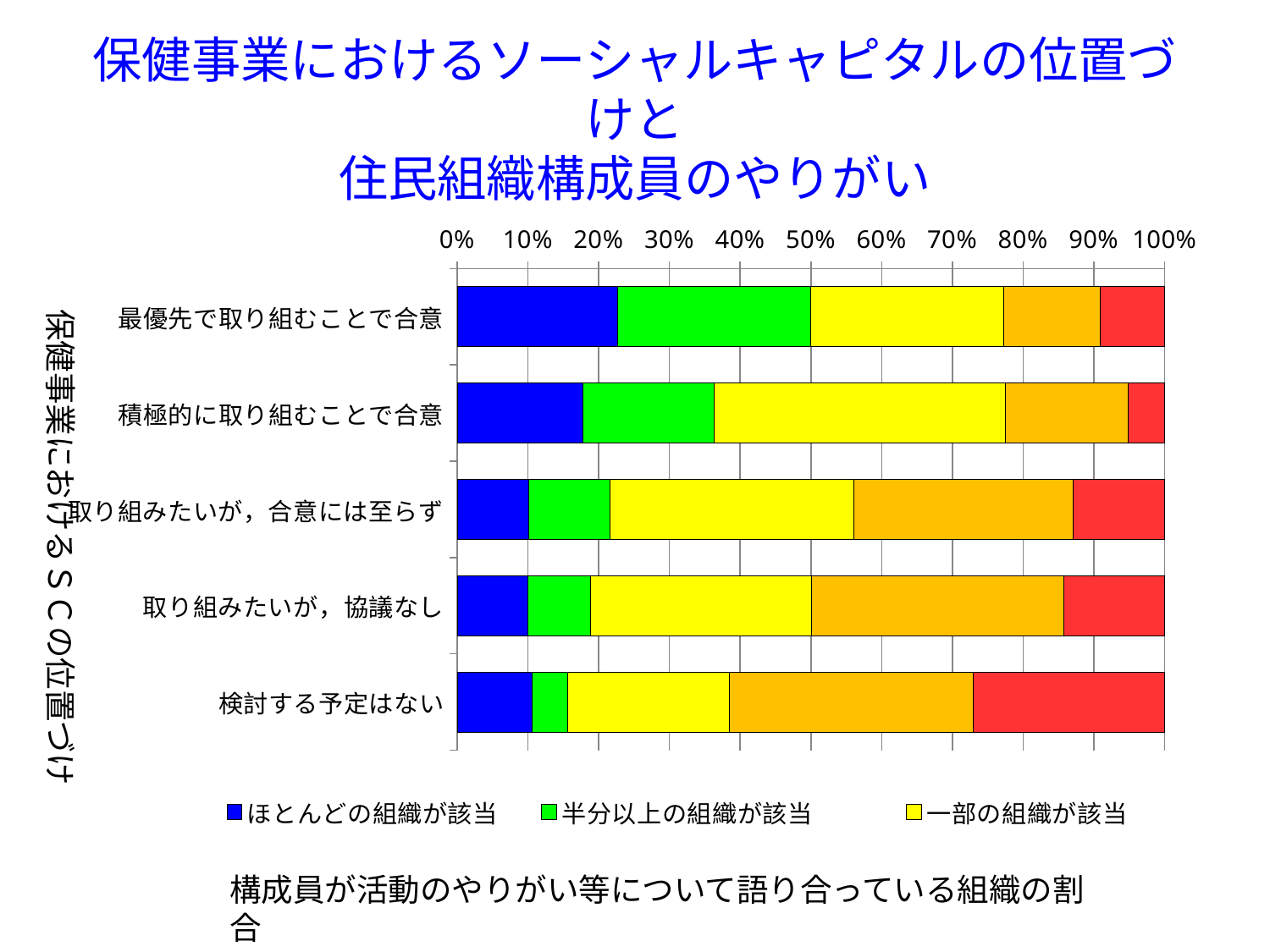
How many series does the legend list? 3 Is the blue segment for 検討する予定はない greater or less than 20%? less Which category has the largest red segment? 検討する予定はない What kind of chart is shown on the slide? Stacked bar chart Is the blue segment for 最優先で取り組むことで合意 greater or less than 20%? greater What is the first entry in the chart legend? ほとんどの組織が該当 Which category has the smallest green (半分以上の組織が該当) segment? 検討する予定はない Which is larger: the blue segment for 最優先で取り組むことで合意 or the blue segment for 検討する予定はない? 最優先で取り組むことで合意 Which category has the largest blue (ほとんどの組織が該当) segment? 最優先で取り組むことで合意 Moving from the top category to the bottom category, does the blue segment get larger or smaller? smaller How many categories are plotted on the vertical axis of the chart? 5 What is the label on the vertical axis of the chart? 保健事業におけるＳＣの位置づけ